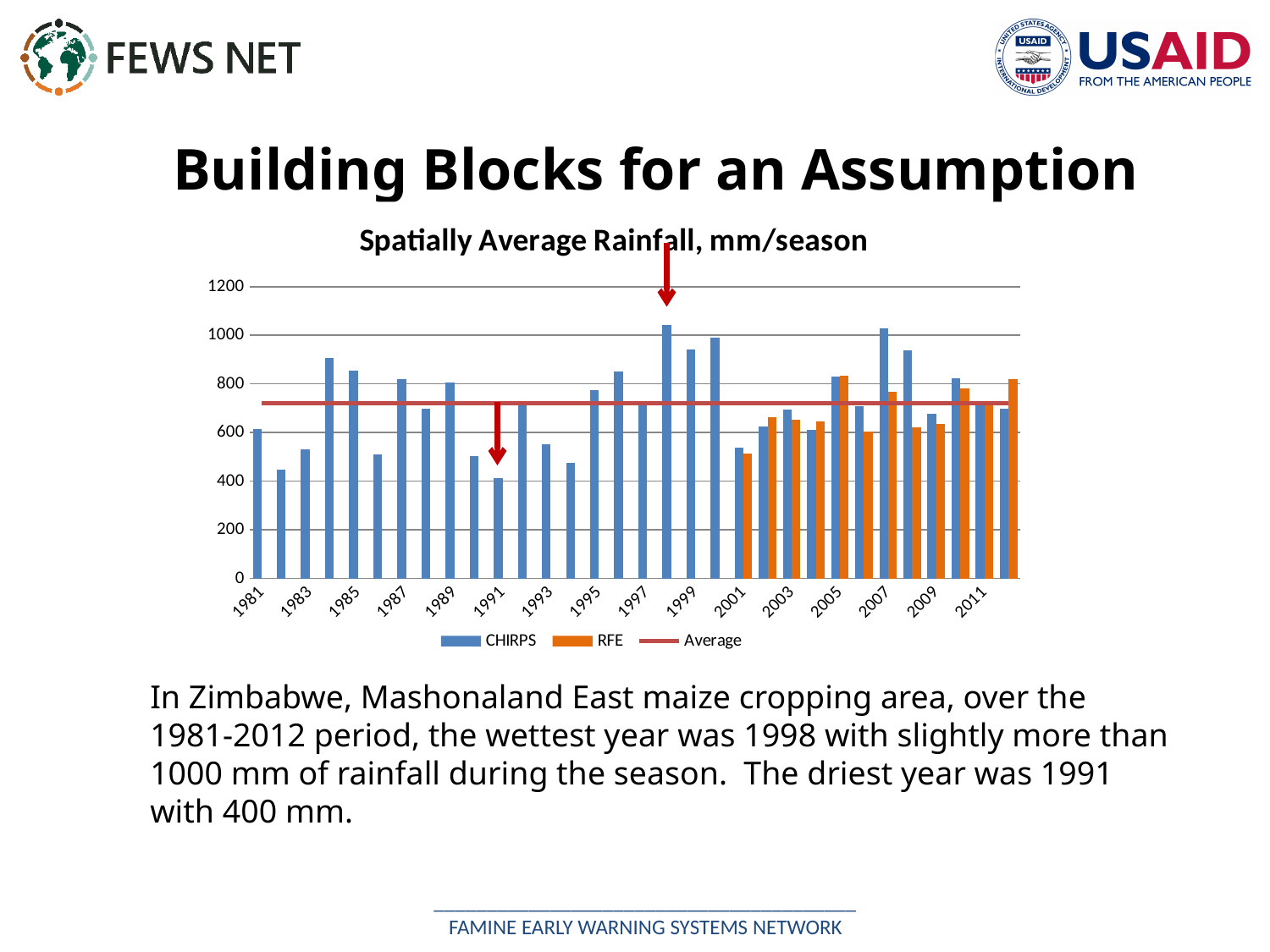
For 2007, which series has the larger value, CHIRPS or RFE? CHIRPS Which year has the highest CHIRPS rainfall value? 1998 How many series does the legend list? 3 Is the CHIRPS value for 1998 greater or less than 800? greater Is the CHIRPS value for 1991 greater or less than 600? less What is the title of the chart? Spatially Average Rainfall, mm/season What kind of chart is shown on the slide? Bar chart Which series are listed in the chart legend? CHIRPS, RFE, Average For 2012, which series has the larger value, CHIRPS or RFE? RFE Which year has the lowest CHIRPS rainfall value? 1991 Is the Average line greater or less than 600? greater